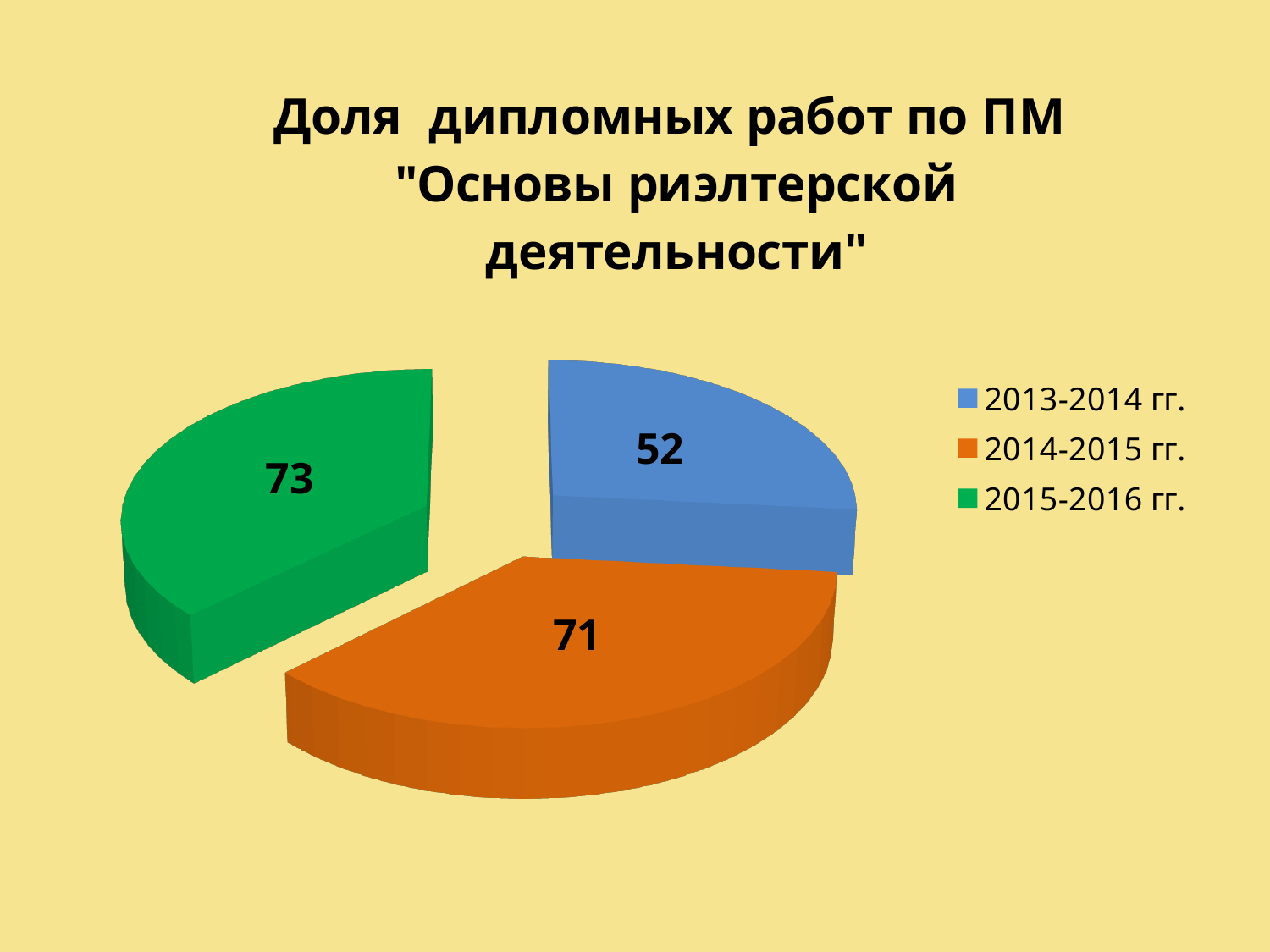
Do the values rise or fall from 2013-2014 гг. to 2015-2016 гг.? Rise Which period has the largest slice? 2015-2016 гг. What is the difference between the values for 2014-2015 гг. and 2013-2014 гг.? 19 What type of chart is shown on the slide? Pie chart What colour is the slice for 2014-2015 гг.? Orange What is the difference between the values for 2015-2016 гг. and 2014-2015 гг.? 2 Which period has the smallest slice? 2013-2014 гг. Which is larger, the value for 2013-2014 гг. or the value for 2015-2016 гг.? 2015-2016 гг. What is the value for 2013-2014 гг.? 52 What is the value for 2014-2015 гг.? 71 What is the value for 2015-2016 гг.? 73 How many slices does the pie chart have? 3